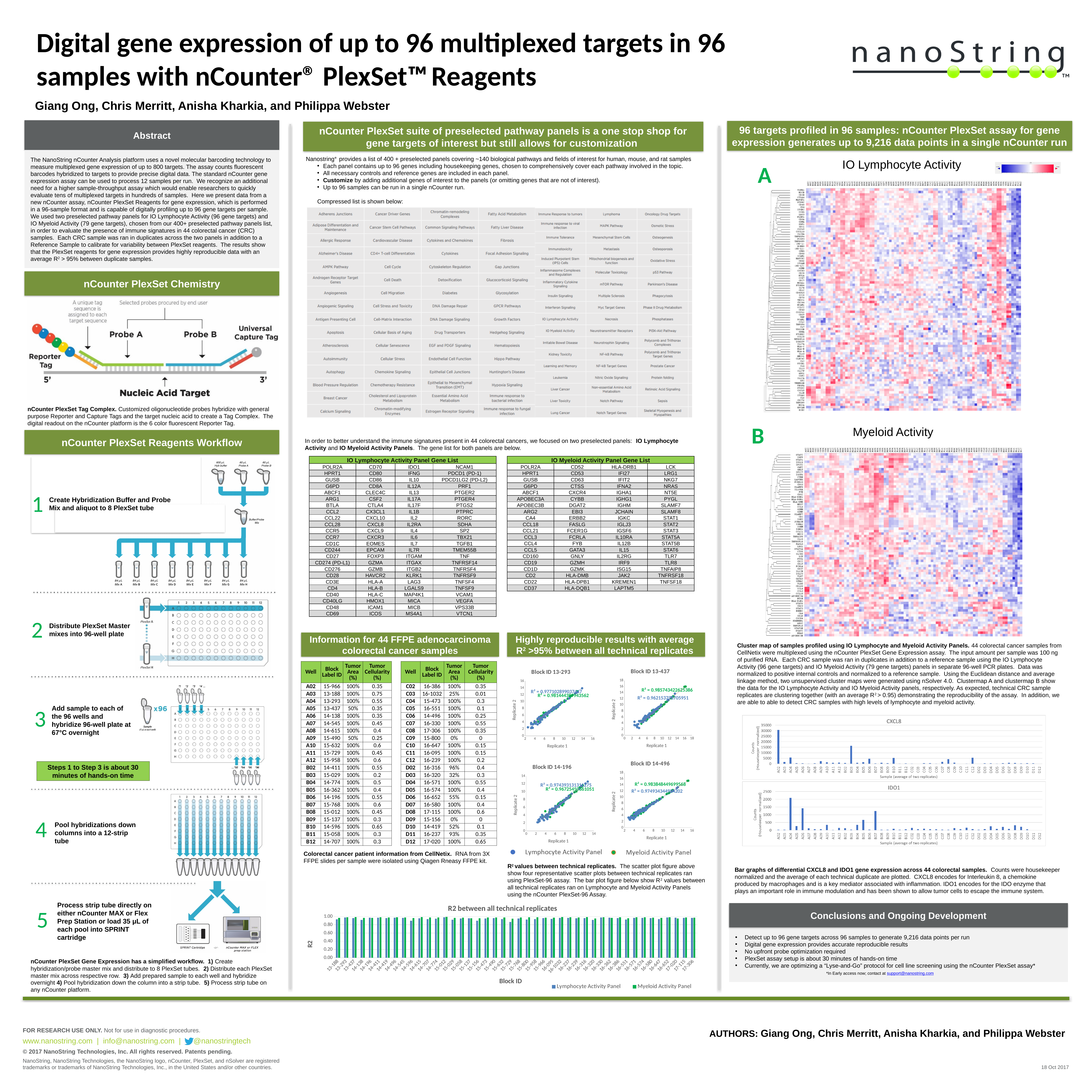
How many scatter plots of technical replicates (Block ID charts) are shown on the slide? 4 In the CXCL8 bar chart, is the value for sample D12 greater or less than 5000? less What kind of chart is the "R2 between all technical replicates" chart? bar chart In the CXCL8 bar chart, is the value for sample A02 greater or less than 25000? greater In the "R2 between all technical replicates" chart, is the value for Block ID 17-306 in the Myeloid Activity Panel greater or less than 0.60? greater What kind of chart is the IDO1 chart? bar chart What is the title of the cluster map labelled B? Myeloid Activity How many series does the legend of the "R2 between all technical replicates" chart list? 2 What are the two legend entries of the "R2 between all technical replicates" chart? Lymphocyte Activity Panel and Myeloid Activity Panel What kind of chart is the "Block ID 13-293" chart? scatter plot